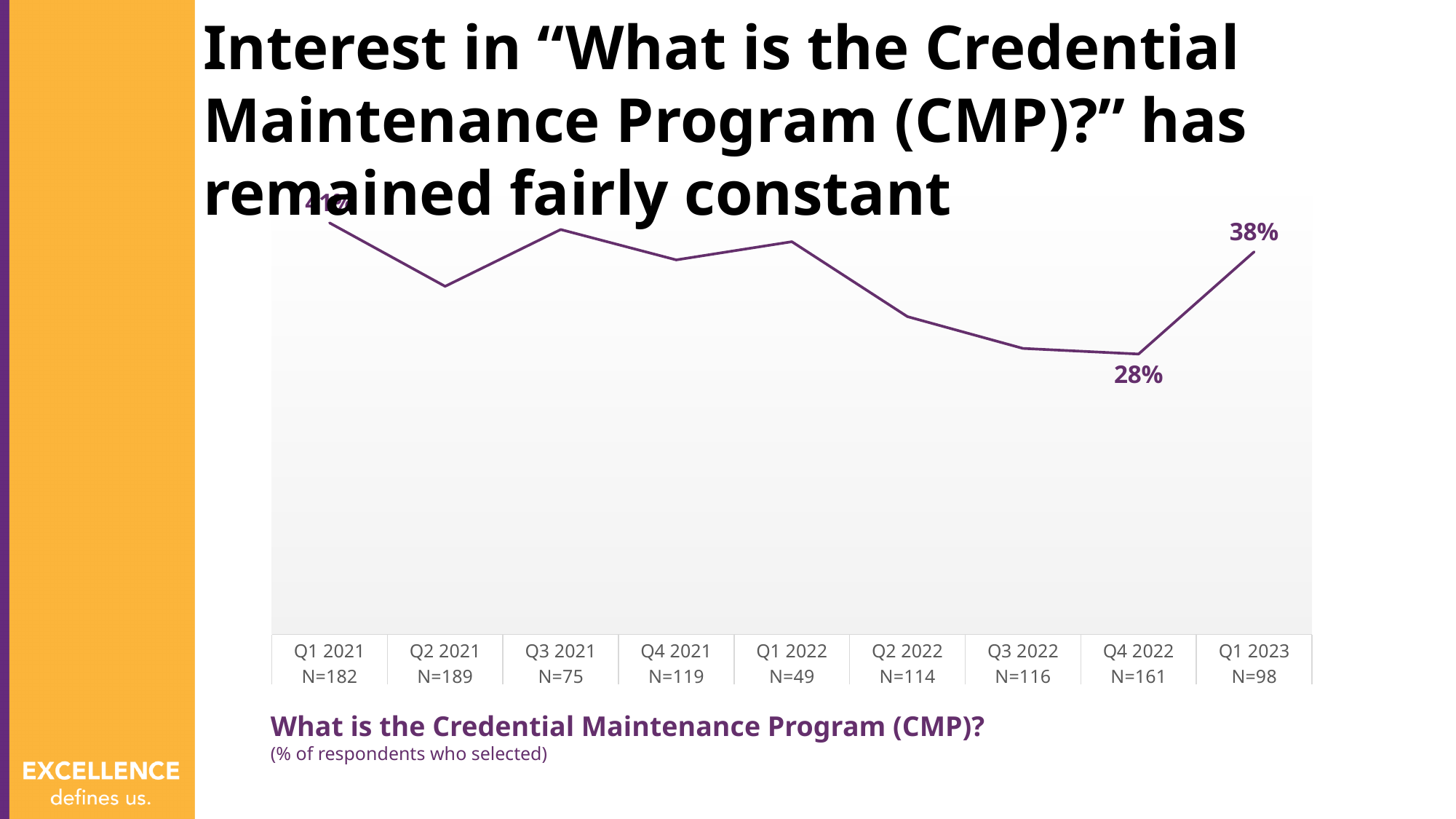
Which is larger, the value for Q1 2022 or the value for Q2 2022? Q1 2022 Do the values rise or fall from Q4 2022 to Q1 2023? rise Which is larger, the value for Q2 2021 or the value for Q3 2021? Q3 2021 What is the value for Q1 2023? 38% What is the difference between the values for Q1 2023 and Q4 2022? 10 percentage points What is the sample size (N) shown for Q3 2021? N=75 Do the values rise or fall from Q1 2022 to Q4 2022? fall How many quarters are plotted on the x axis? 9 Which is larger, the value for Q1 2023 or the value for Q4 2022? Q1 2023 What is the title printed below the chart? What is the Credential Maintenance Program (CMP)? What is the value for Q4 2022? 28% What kind of chart is shown on the slide? line chart